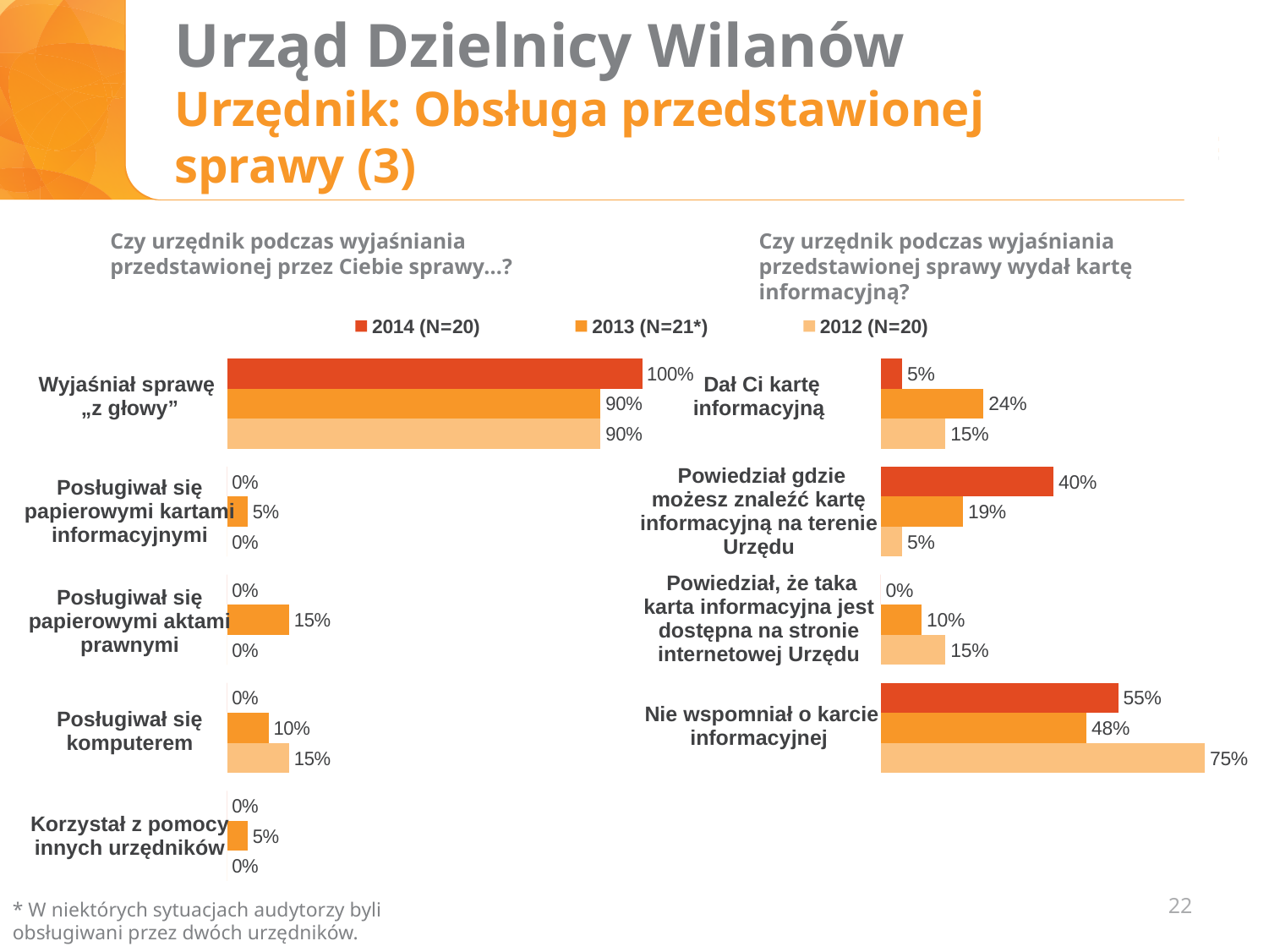
In the left chart, how many categories are shown? 5 In the right chart ("Czy urzędnik podczas wyjaśniania przedstawionej sprawy wydał kartę informacyjną?"), what is the 2012 (N=20) value for "Nie wspomniał o karcie informacyjnej"? 75% In the left chart, what is the 2012 (N=20) value for "Posługiwał się komputerem"? 15% How many series does the legend list? 3 In the right chart, what is the 2014 (N=20) value for "Powiedział gdzie możesz znaleźć kartę informacyjną na terenie Urzędu"? 40% In the left chart ("Czy urzędnik podczas wyjaśniania przedstawionej przez Ciebie sprawy...?"), what is the 2014 (N=20) value for "Wyjaśniał sprawę „z głowy”"? 100% In the right chart, for "Dał Ci kartę informacyjną", which is larger: the 2013 (N=21*) value or the 2012 (N=20) value? 2013 (N=21*) In the right chart, what is the difference between the 2014 (N=20) and 2013 (N=21*) values for "Powiedział gdzie możesz znaleźć kartę informacyjną na terenie Urzędu"? 21% In the right chart, which category has the highest 2013 (N=21*) value? Nie wspomniał o karcie informacyjnej In the left chart, what is the 2013 (N=21*) value for "Posługiwał się papierowymi aktami prawnymi"? 15% In the right chart, how many categories are shown? 4 What type of chart is the left chart? bar chart